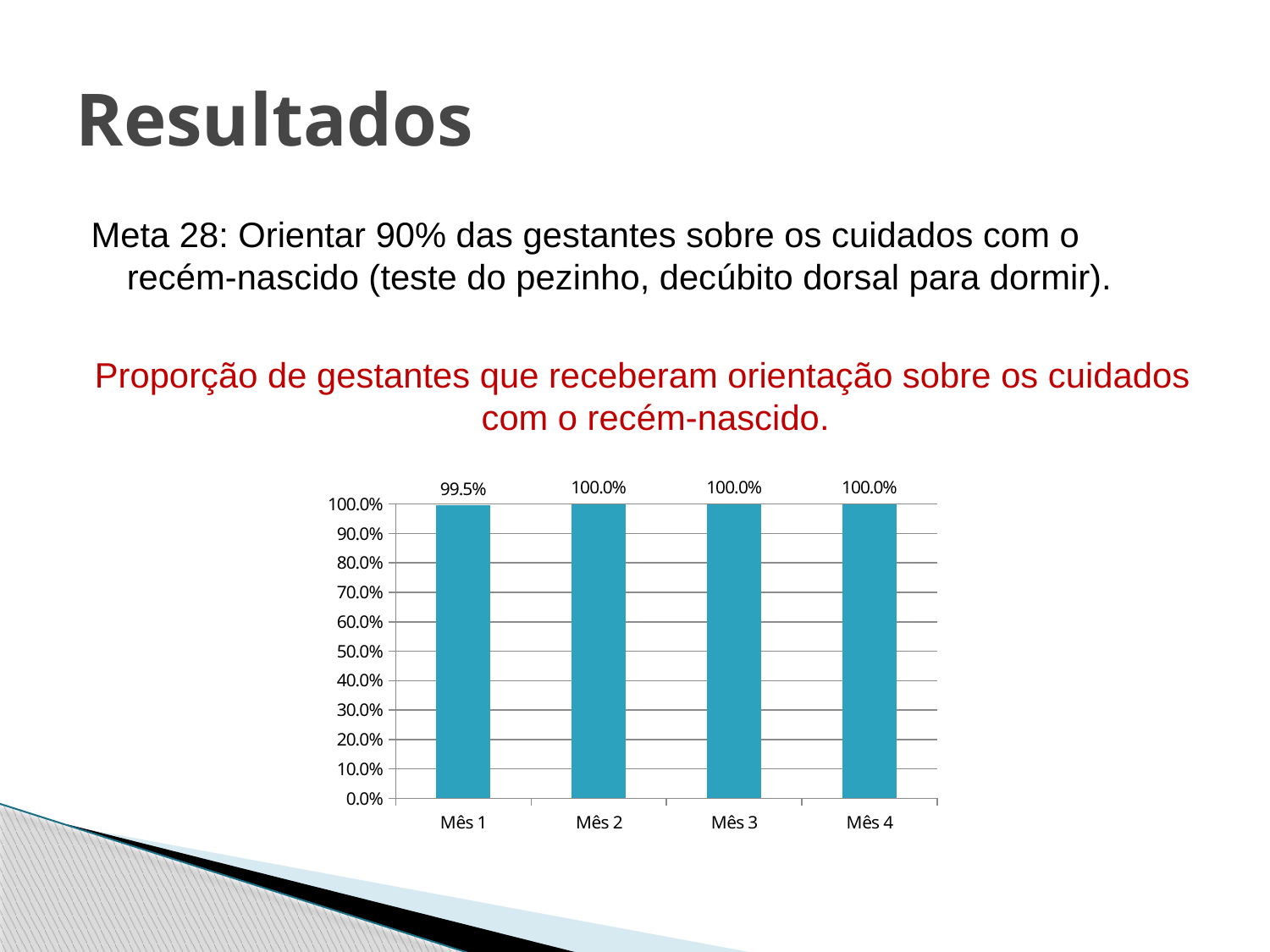
Does the value rise or fall from Mês 1 to Mês 2? rise How many months are shown on the x axis? 4 What is the value for Mês 4? 100.0% Is the value for Mês 3 greater or less than 90.0%? greater Which is larger, the value for Mês 1 or the value for Mês 3? Mês 3 What is the title of the chart? Proporção de gestantes que receberam orientação sobre os cuidados com o recém-nascido. What is the value for Mês 1? 99.5% What kind of chart is shown on the slide? bar chart Which month has the lowest value? Mês 1 What colour are the bars in the chart? blue What is the difference between the values for Mês 2 and Mês 1? 0.5% What is the value for Mês 2? 100.0%